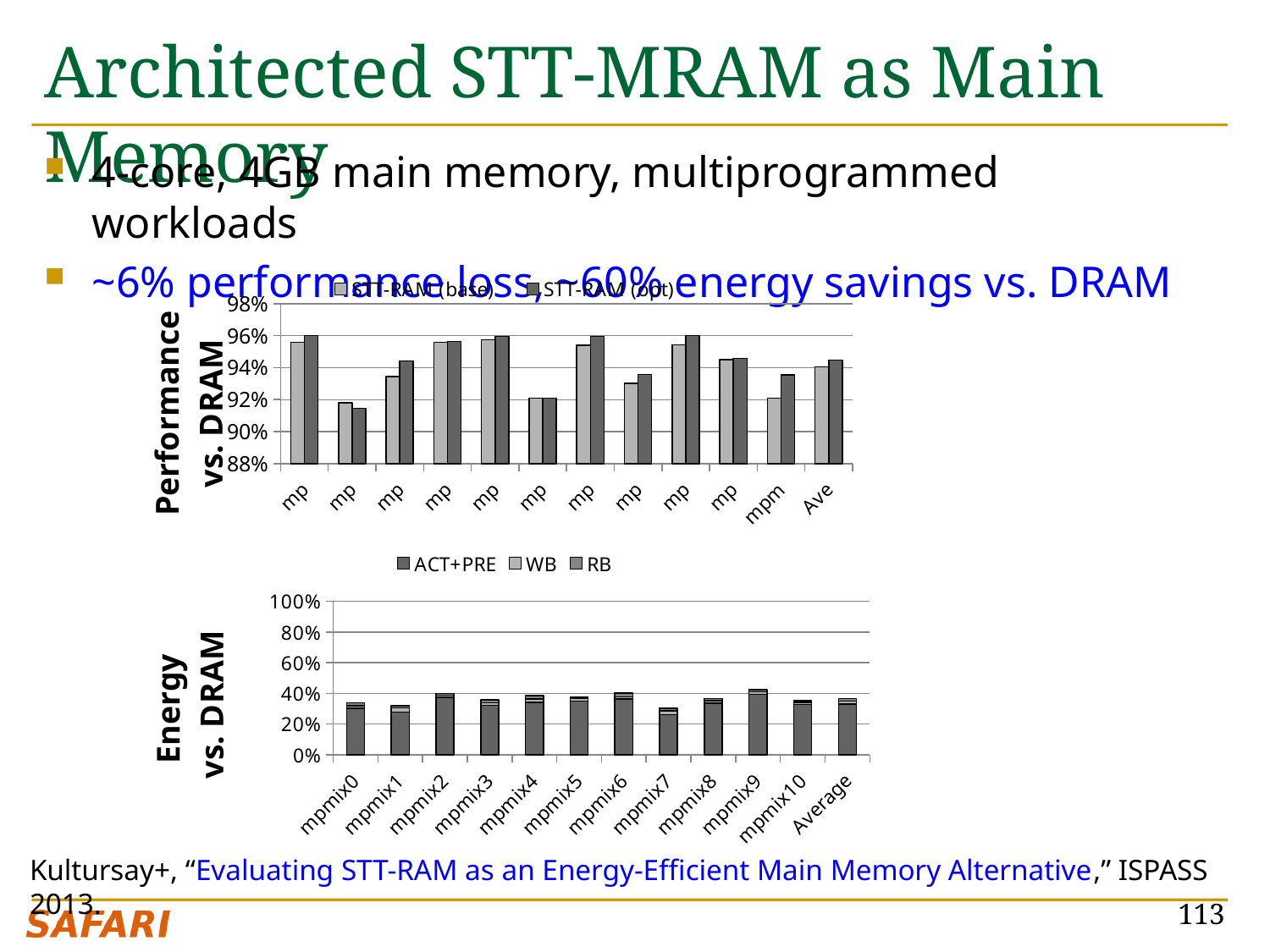
In the top chart (Performance vs. DRAM), is the STT-RAM (opt) value for Ave greater or less than 92%? greater In the bottom chart (Energy vs. DRAM), is the total for mpmix7 greater or less than 40%? less What kind of chart is the bottom chart (Energy vs. DRAM)? stacked bar chart In the bottom chart (Energy vs. DRAM), how many categories are shown on the x axis? 12 What is the y-axis label of the top chart? Performance vs. DRAM What kind of chart is the top chart (Performance vs. DRAM)? bar chart In the top chart (Performance vs. DRAM), how many series does the legend list? 2 In the bottom chart (Energy vs. DRAM), what are the legend entries? ACT+PRE, WB, RB In the bottom chart (Energy vs. DRAM), how many series does the legend list? 3 In the bottom chart (Energy vs. DRAM), is the total for Average greater or less than 60%? less In the bottom chart (Energy vs. DRAM), which has the larger total, mpmix9 or mpmix7? mpmix9